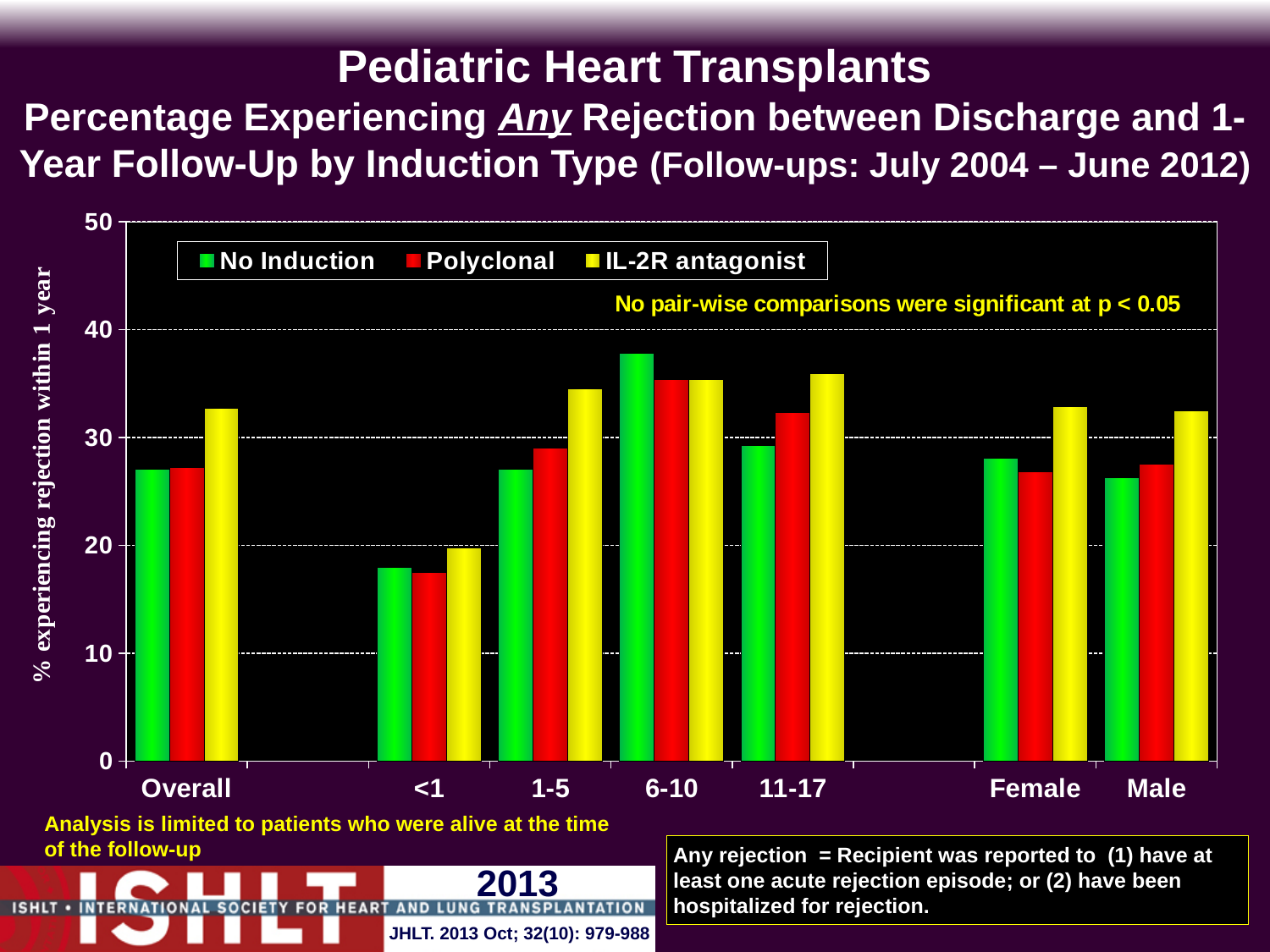
How many categories are shown along the x axis? 7 In the 11-17 age group, which induction type has the highest value? IL-2R antagonist Is the value for No Induction in the 6-10 age group greater or less than 30? greater In the 1-5 age group, which is larger: No Induction or IL-2R antagonist? IL-2R antagonist Is the value for No Induction in the <1 age group greater or less than 20? less Is the value for IL-2R antagonist in the Overall group greater or less than 30? greater Which age group has the lowest values for all three induction types? <1 Which colour represents Polyclonal in the legend? red How many series does the legend list? 3 Which age group has the highest No Induction value? 6-10 What kind of chart is shown on the slide? bar chart